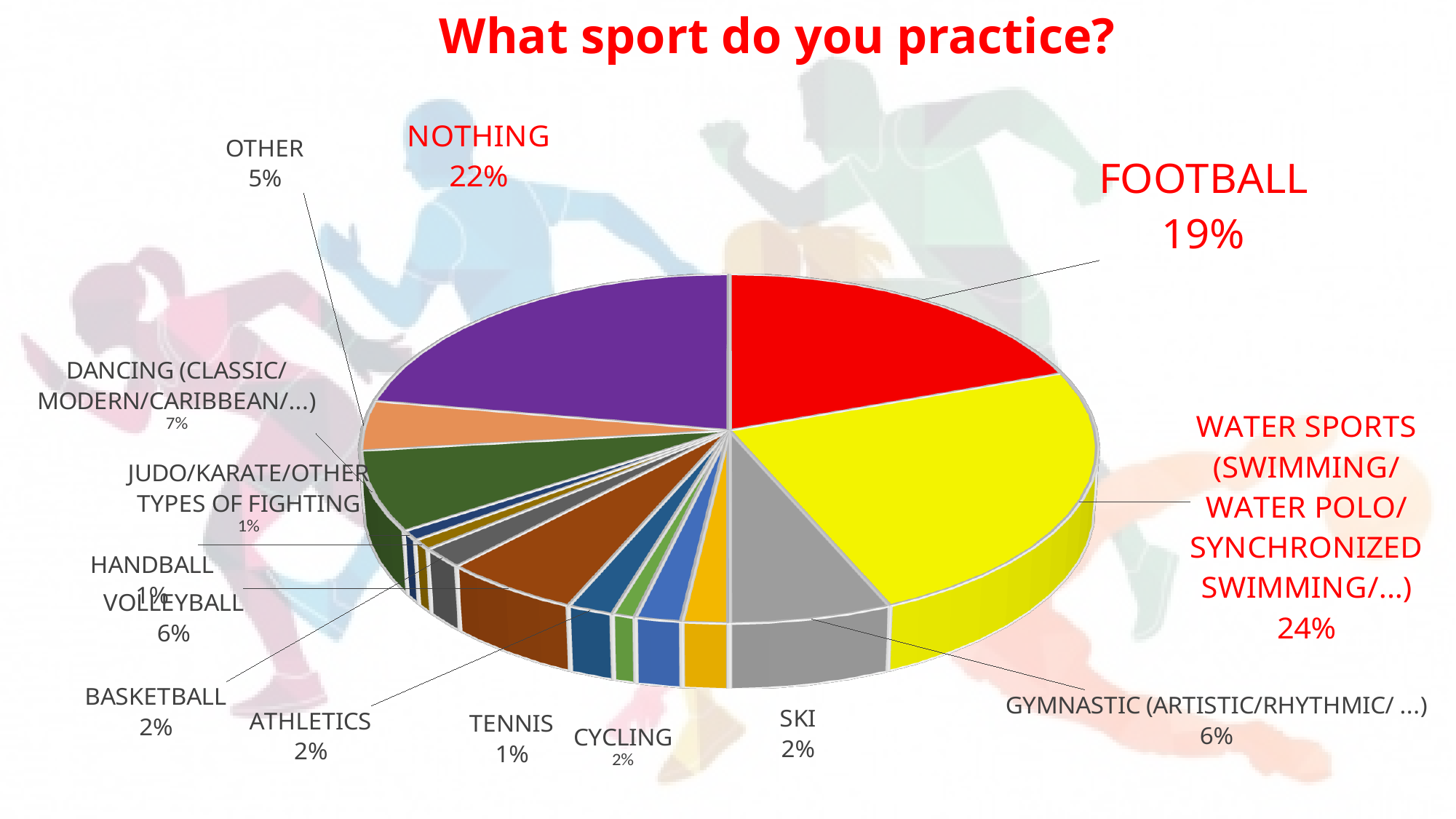
What percentage of respondents practice football? 19% What is the title of the chart? What sport do you practice? What share of the pie is taken by water sports (swimming/water polo/synchronized swimming/...)? 24% How many categories are shown in the pie chart? 14 Which is larger, the share for 'Nothing' or the share for football? Nothing What percentage of respondents practice dancing (classic/modern/caribbean/...)? 7% What percentage of respondents answered 'Nothing'? 22% What type of chart is shown on the slide? Pie chart What percentage of respondents practice tennis? 1% Which category has the largest slice of the pie? Water sports (swimming/water polo/synchronized swimming/...) What percentage of respondents practice volleyball? 6% What is the difference in percentage points between water sports and football? 5%